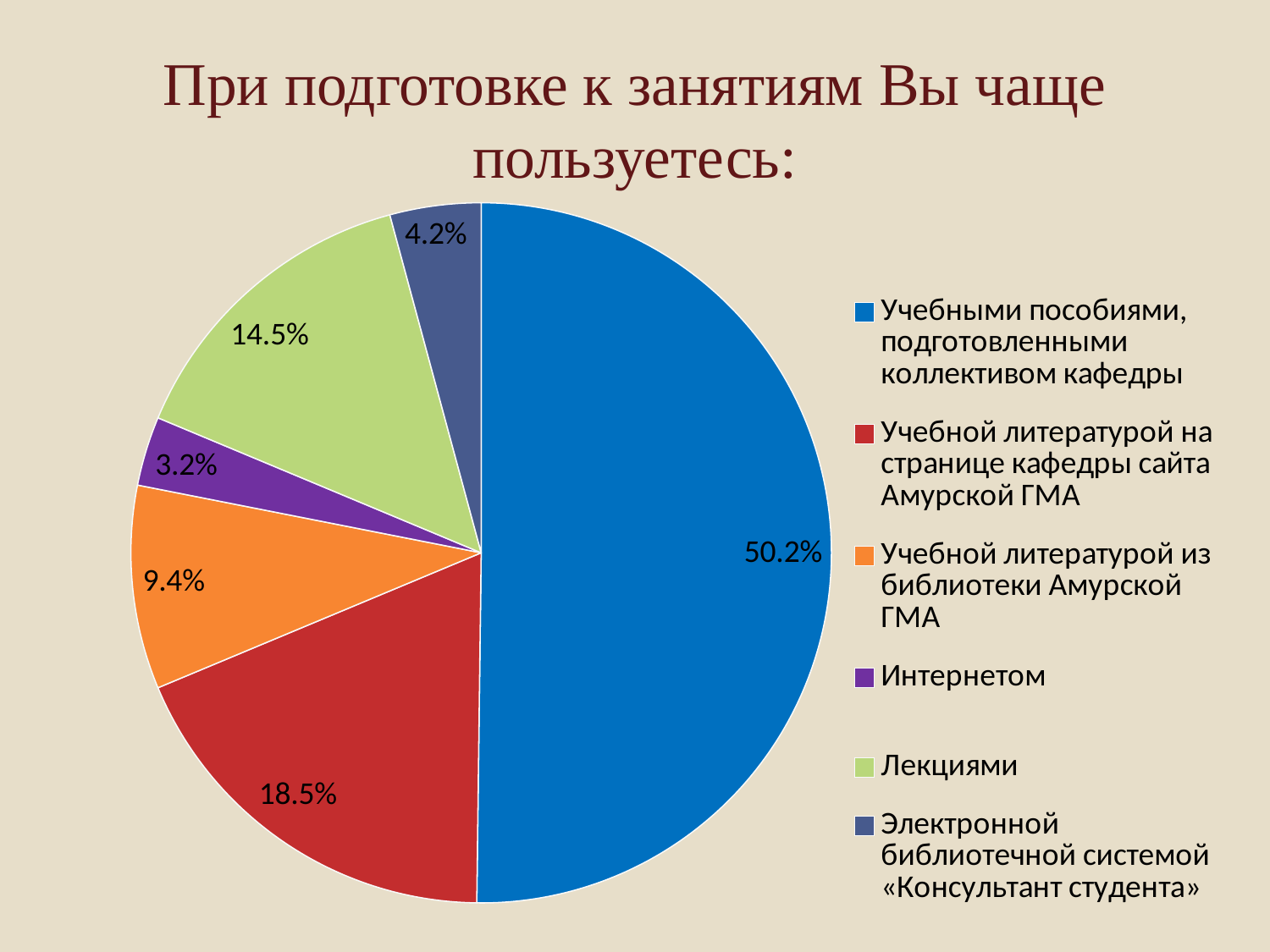
What value is shown for «Учебной литературой на странице кафедры сайта Амурской ГМА»? 18.5% What value is shown for «Лекциями»? 14.5% How many categories does the legend list? 6 Which category has the largest slice of the pie? Учебными пособиями, подготовленными коллективом кафедры Which is larger: the slice for «Лекциями» or the slice for «Учебной литературой из библиотеки Амурской ГМА»? Лекциями What kind of chart is shown on the slide? pie chart What value is shown for «Электронной библиотечной системой «Консультант студента»»? 4.2% What value is shown for «Интернетом»? 3.2% What is the difference between the values for «Учебной литературой на странице кафедры сайта Амурской ГМА» and «Лекциями»? 4.0% What value is shown for «Учебной литературой из библиотеки Амурской ГМА»? 9.4% What share of the pie is labelled for «Учебными пособиями, подготовленными коллективом кафедры»? 50.2% Which category has the smallest slice of the pie? Интернетом